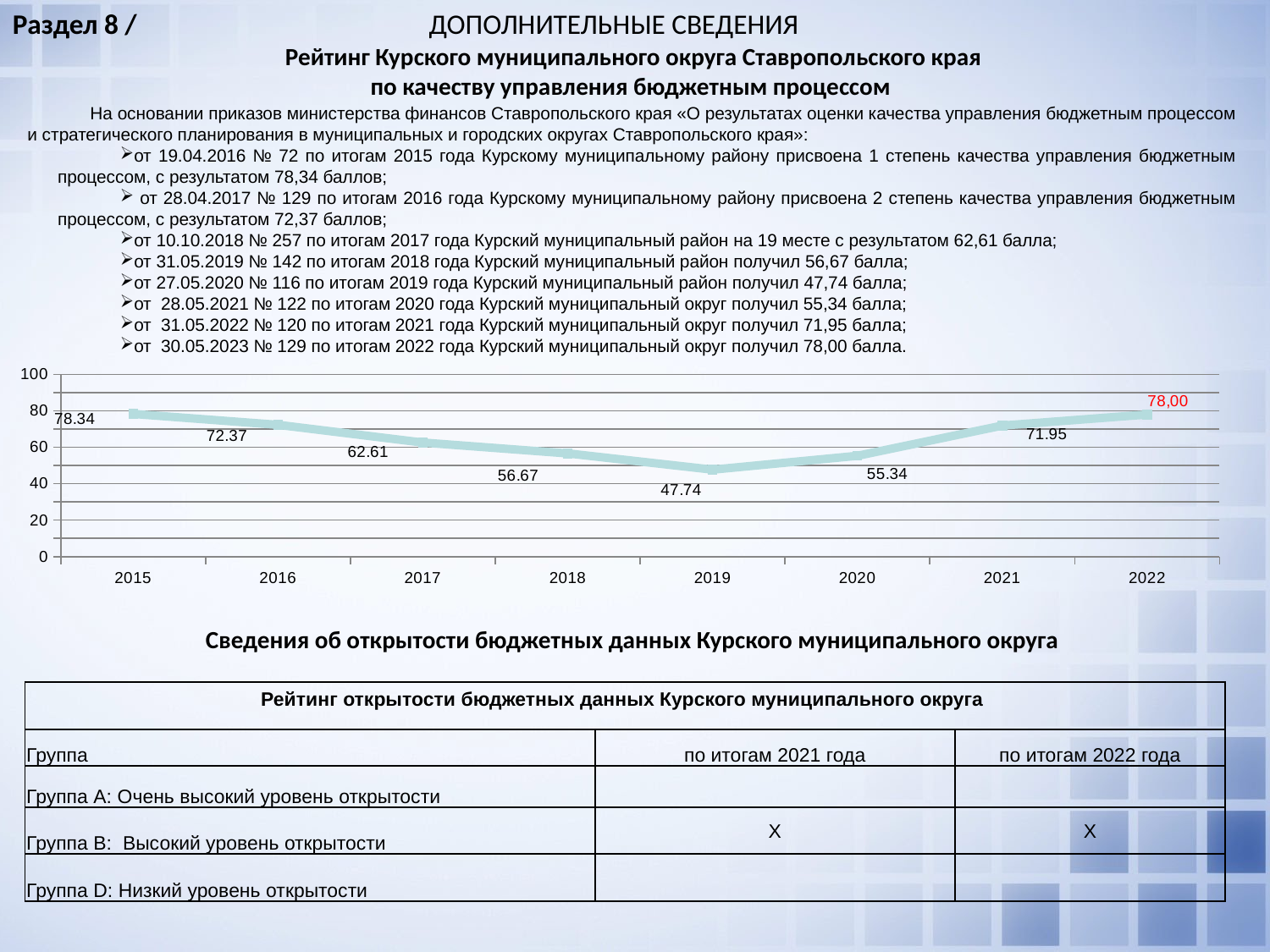
What is the difference between the values for 2021 and 2020? 16.61 What is the value plotted for 2022? 78,00 Which is larger, the value for 2017 or the value for 2020? 2017 What is the difference between the values for 2015 and 2016? 5.97 Is the value for 2019 greater or less than 60? less What is the value plotted for 2020? 55.34 What is the value plotted for 2015? 78.34 What type of chart is shown on the slide? line chart Do the values rise or fall from 2019 to 2022? rise Which year has the lowest value on the chart? 2019 What is the value plotted for 2019? 47.74 How many years are plotted on the x axis of the chart? 8